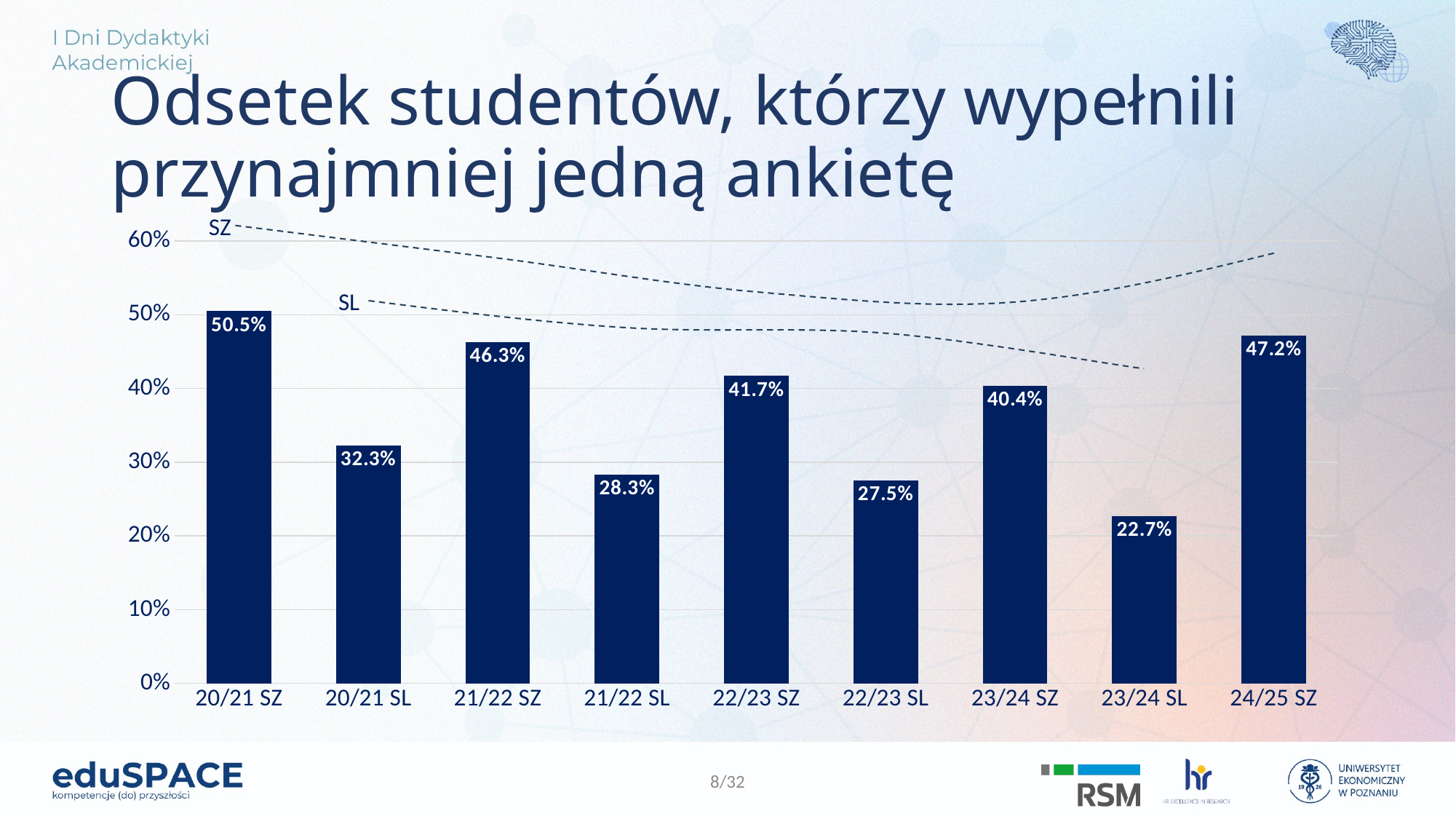
What kind of chart is shown on the slide? bar chart Which category has the highest value? 20/21 SZ What is the value for 22/23 SZ? 41.7% Which is larger, the value for 21/22 SZ or the value for 24/25 SZ? 24/25 SZ What is the difference between the values for 24/25 SZ and 23/24 SL? 24.5% What is the value for 23/24 SL? 22.7% What is the title of the chart? Odsetek studentów, którzy wypełnili przynajmniej jedną ankietę Which category has the lowest value? 23/24 SL What is the value for 20/21 SZ? 50.5% Do the values for the SL semesters rise or fall from 20/21 SL to 23/24 SL? fall How many categories are shown on the x axis? 9 Is the value for 22/23 SL greater or less than 30%? less